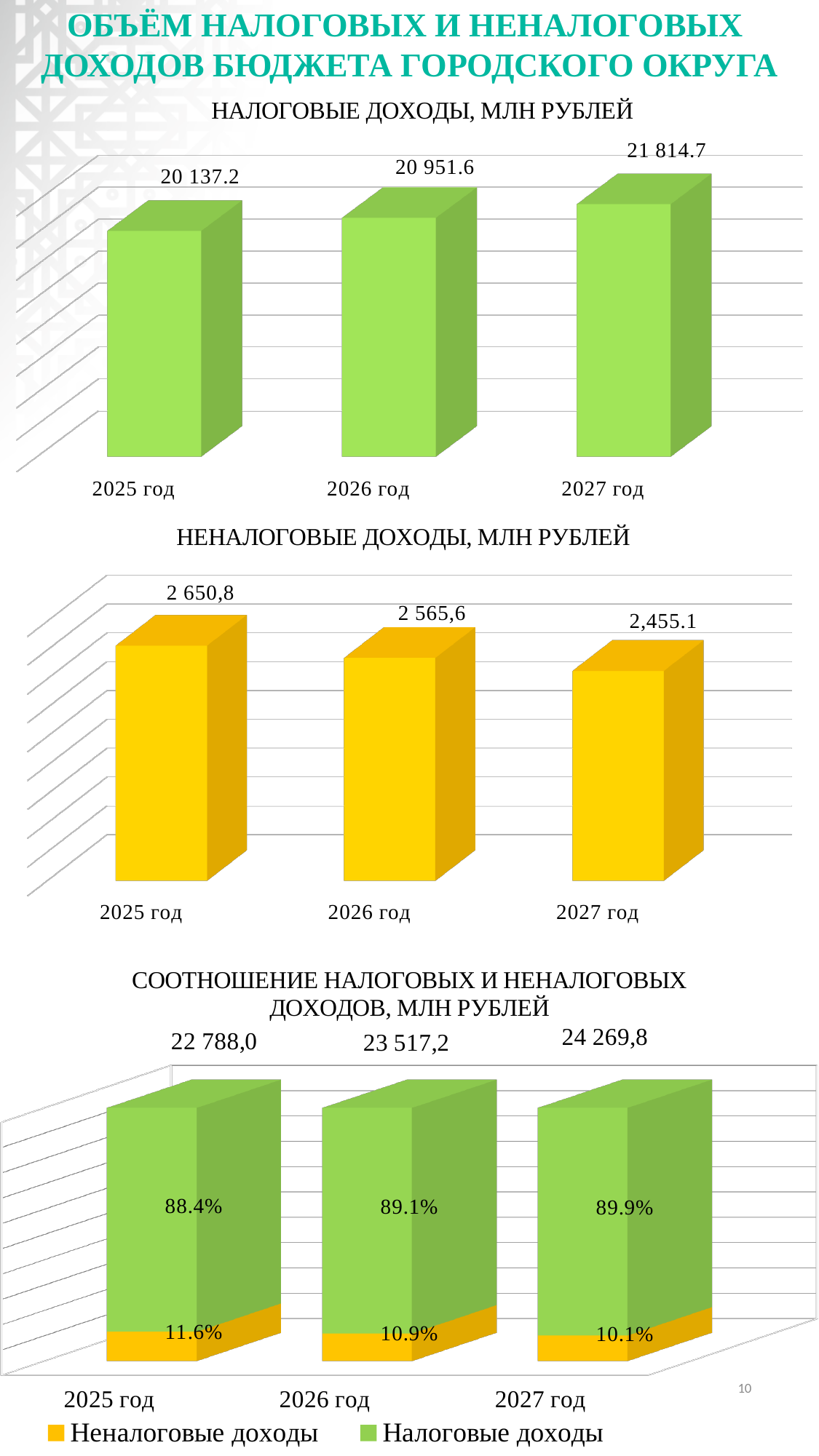
In the chart titled 'НАЛОГОВЫЕ ДОХОДЫ, МЛН РУБЛЕЙ', do the values rise or fall from 2025 год to 2027 год? rise In the chart titled 'НАЛОГОВЫЕ ДОХОДЫ, МЛН РУБЛЕЙ', what is the difference between the values for 2027 год and 2025 год? 1 677.5 What kind of chart is the chart titled 'НАЛОГОВЫЕ ДОХОДЫ, МЛН РУБЛЕЙ'? bar chart In the chart titled 'СООТНОШЕНИЕ НАЛОГОВЫХ И НЕНАЛОГОВЫХ ДОХОДОВ, МЛН РУБЛЕЙ', how many series does the legend list? 2 In the chart titled 'НАЛОГОВЫЕ ДОХОДЫ, МЛН РУБЛЕЙ', what is the value for 2026 год? 20 951.6 In the chart titled 'СООТНОШЕНИЕ НАЛОГОВЫХ И НЕНАЛОГОВЫХ ДОХОДОВ, МЛН РУБЛЕЙ', what percentage share do Неналоговые доходы have in 2027 год? 10.1% In the chart titled 'НЕНАЛОГОВЫЕ ДОХОДЫ, МЛН РУБЛЕЙ', which year has the lowest value? 2027 год In the chart titled 'СООТНОШЕНИЕ НАЛОГОВЫХ И НЕНАЛОГОВЫХ ДОХОДОВ, МЛН РУБЛЕЙ', what is the total shown above the bar for 2026 год? 23 517,2 In the chart titled 'НЕНАЛОГОВЫЕ ДОХОДЫ, МЛН РУБЛЕЙ', what is the value for 2025 год? 2 650,8 In the chart titled 'НАЛОГОВЫЕ ДОХОДЫ, МЛН РУБЛЕЙ', which year has the highest value? 2027 год In the chart titled 'НЕНАЛОГОВЫЕ ДОХОДЫ, МЛН РУБЛЕЙ', how many years are shown? 3 In the chart titled 'НЕНАЛОГОВЫЕ ДОХОДЫ, МЛН РУБЛЕЙ', do the values rise or fall from 2025 год to 2027 год? fall